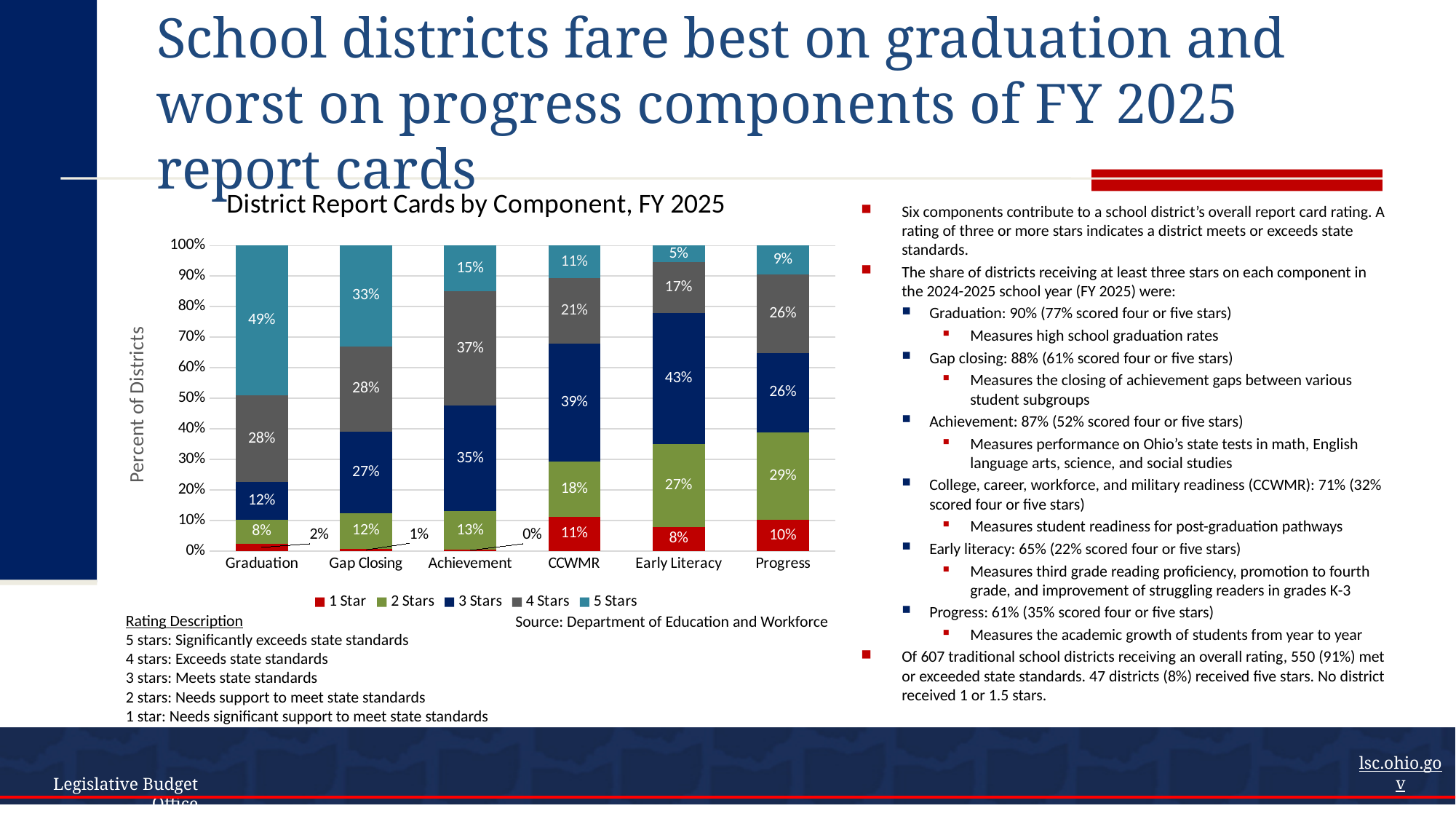
What is the difference between the 4 Stars share for Achievement and the 4 Stars share for Early Literacy? 20% What percentage of districts received 5 Stars on the Graduation component? 49% Which component has the lowest share of districts receiving 5 Stars? Early Literacy How many series does the chart legend list? 5 Which component has the highest share of districts receiving 5 Stars? Graduation Which is larger: the 2 Stars share for Progress or the 2 Stars share for Gap Closing? Progress What percentage of districts received 1 Star on the CCWMR component? 11% What is the label on the vertical axis of the chart? Percent of Districts What is the title of the chart? District Report Cards by Component, FY 2025 What percentage of districts received 3 Stars on the Early Literacy component? 43% How many components (categories) are shown on the x axis of the chart? 6 What kind of chart is shown on the slide? Stacked bar chart